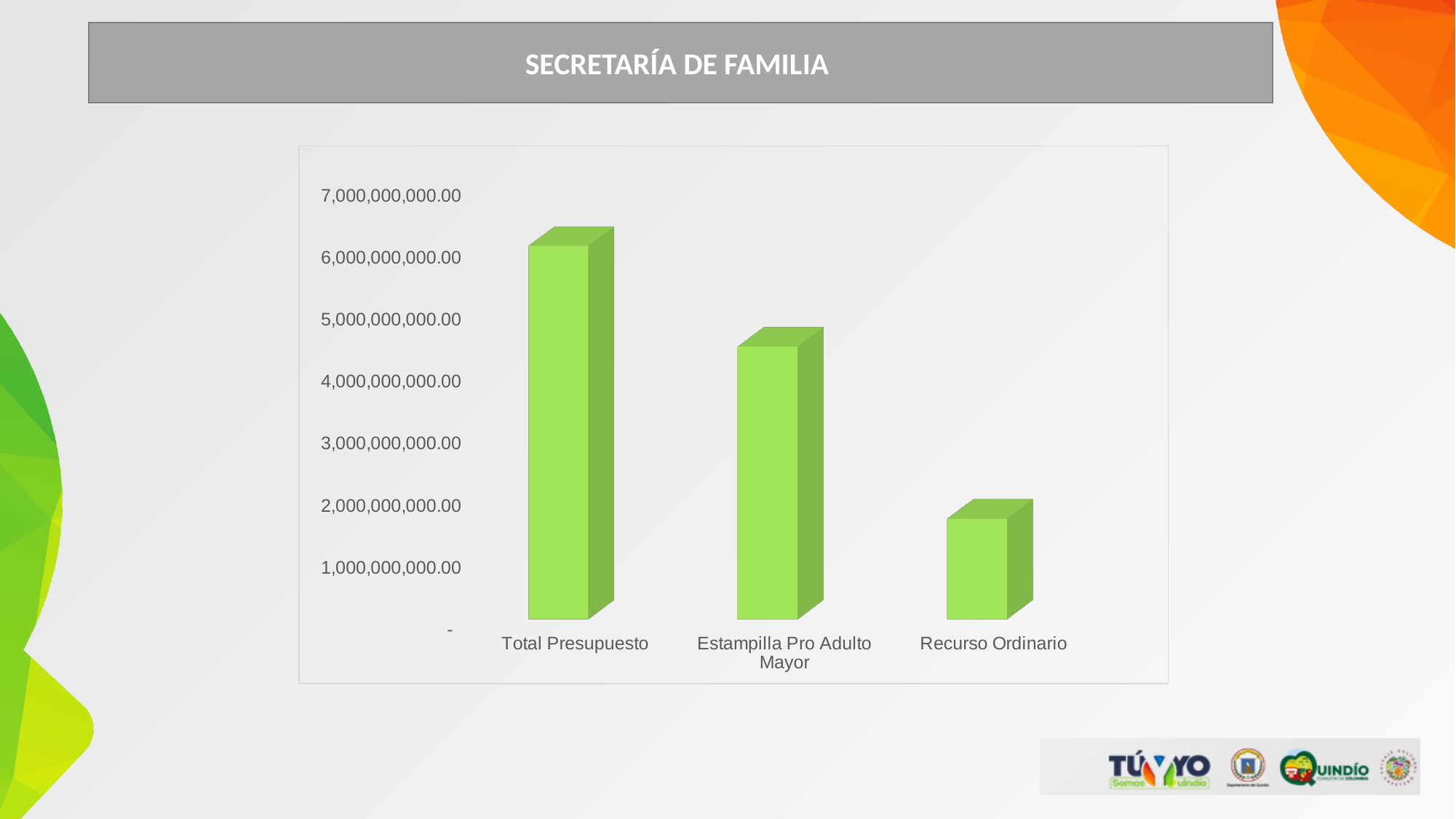
Is the value for Recurso Ordinario greater or less than 2,000,000,000.00? less How many categories are plotted on the chart? 3 Which category has the lowest bar? Recurso Ordinario What colour are the bars in the chart? green Is the value for Estampilla Pro Adulto Mayor greater or less than 5,000,000,000.00? less Which category has the highest bar? Total Presupuesto What is the title shown in the header above the chart? SECRETARÍA DE FAMILIA What kind of chart is shown on the slide? bar chart Is the value for Recurso Ordinario greater or less than 1,000,000,000.00? greater Which is larger, the value for Estampilla Pro Adulto Mayor or the value for Recurso Ordinario? Estampilla Pro Adulto Mayor Do the bar values rise or fall from left to right across the categories? fall